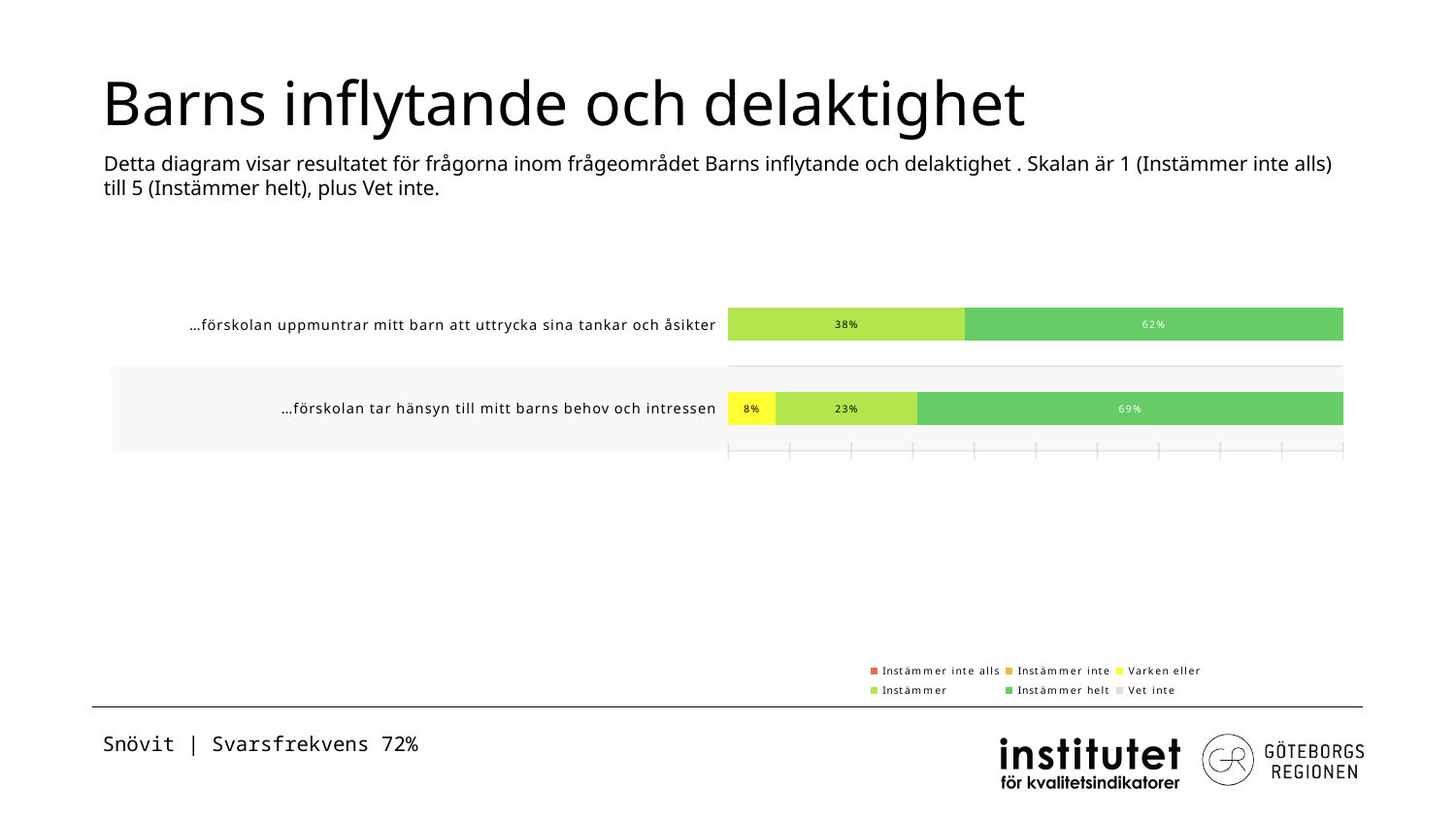
What colour represents 'Varken eller' in the legend? yellow How many categories (statements) are plotted in the chart? 2 How many series does the legend list? 6 What kind of chart is shown on the slide? stacked bar chart What is the 'Instämmer helt' value for '…förskolan tar hänsyn till mitt barns behov och intressen'? 69% Is the 'Instämmer helt' value for '…förskolan uppmuntrar mitt barn att uttrycka sina tankar och åsikter' larger or smaller than its 'Instämmer' value? larger Which statement has the higher 'Instämmer helt' share? …förskolan tar hänsyn till mitt barns behov och intressen What is the difference between the 'Instämmer' values of the two statements (38% vs 23%)? 15% What is the 'Instämmer' value for '…förskolan tar hänsyn till mitt barns behov och intressen'? 23% What is the 'Varken eller' value for '…förskolan tar hänsyn till mitt barns behov och intressen'? 8% What is the 'Instämmer helt' value for '…förskolan uppmuntrar mitt barn att uttrycka sina tankar och åsikter'? 62% What is the 'Instämmer' value for '…förskolan uppmuntrar mitt barn att uttrycka sina tankar och åsikter'? 38%